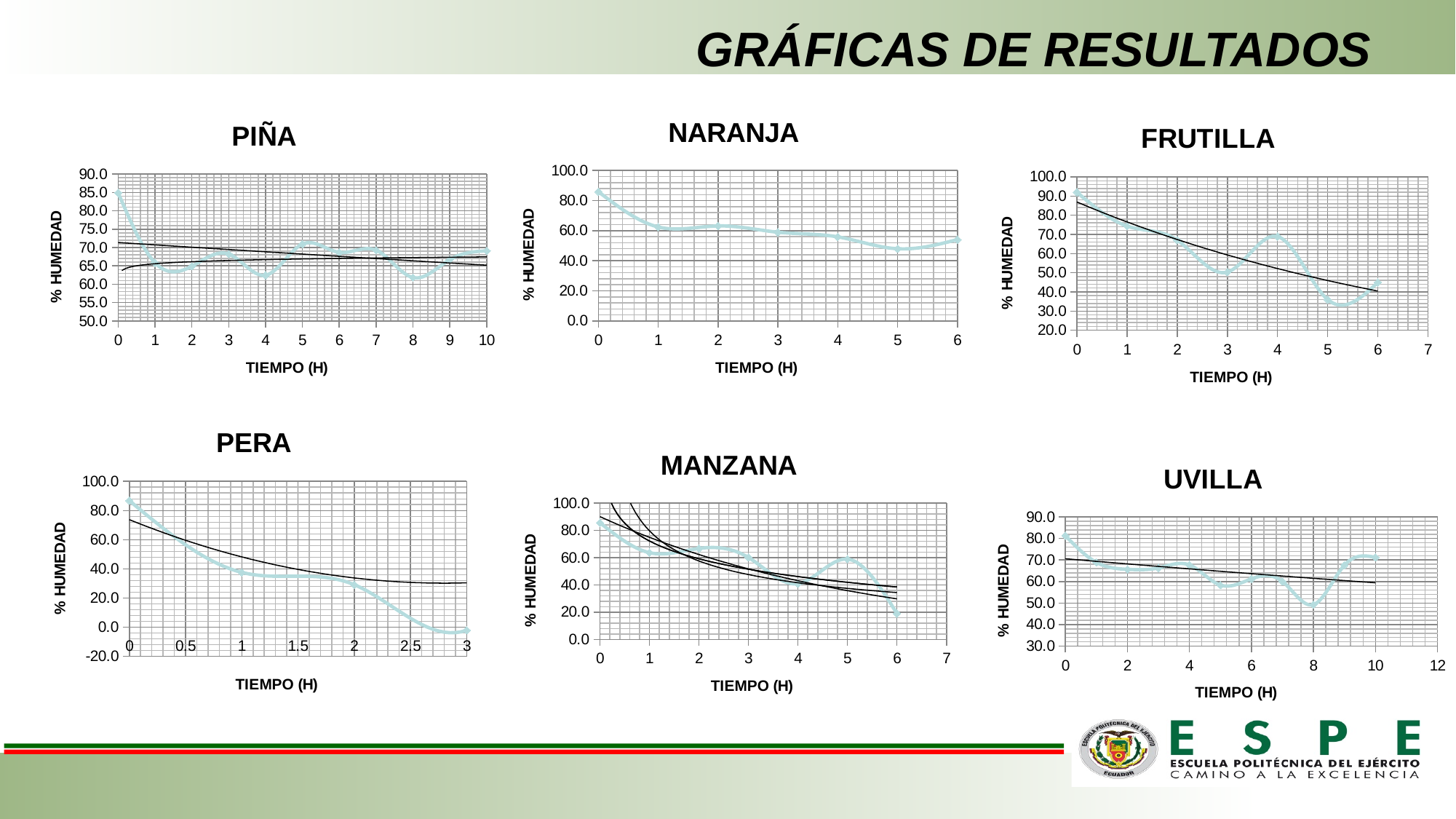
In the MANZANA chart, is the value at time 6 greater or less than 40? less In the MANZANA chart, is the value at time 0 greater or less than 80? greater In the NARANJA chart, do the values generally rise or fall as time increases? fall In the NARANJA chart, is the value at time 0 greater or less than 80? greater What kind of chart is the PIÑA chart? line chart What is the y-axis label of the UVILLA chart? % HUMEDAD How many charts are shown on the slide? 6 What is the x-axis label of the FRUTILLA chart? TIEMPO (H) In the PERA chart, do the values generally rise or fall as time increases? fall